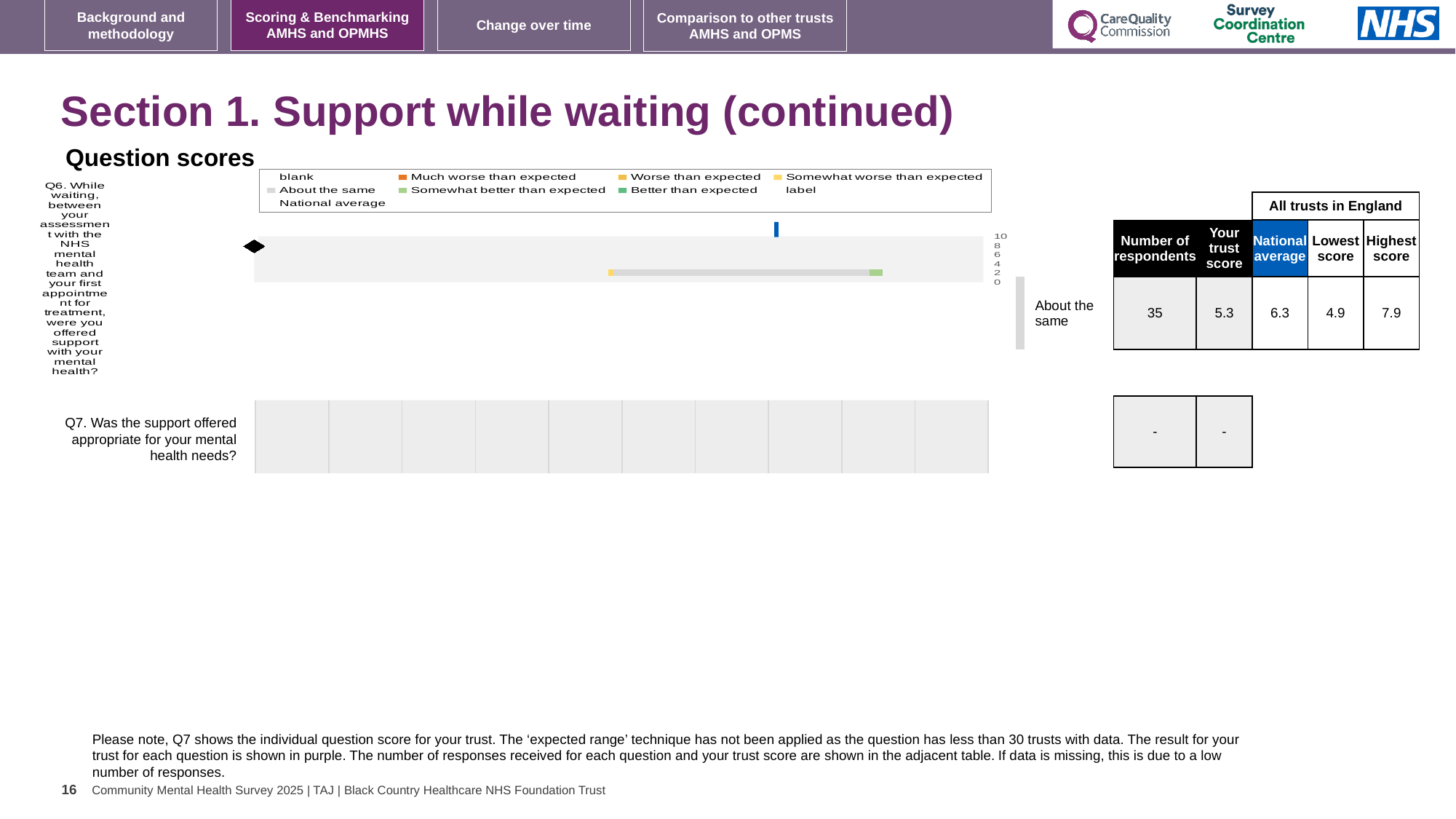
What is the lowest score across all trusts in England for Q6? 4.9 What is the difference between the highest and lowest trust scores for Q6? 3.0 How many respondents answered Q6? 35 Which expected-range category is the trust's Q6 result labelled as? About the same What is the difference between the national average and the trust score for Q6? 1.0 Is the trust score for Q6 greater or less than 6? less How many questions are shown as rows in the question scores chart? 2 What is the highest score across all trusts in England for Q6? 7.9 For Q6, which is larger: the trust score or the national average? National average What is the national average score for Q6? 6.3 What type of chart is used to show the question scores? bar chart What is the trust score for Q6 in the question scores chart? 5.3